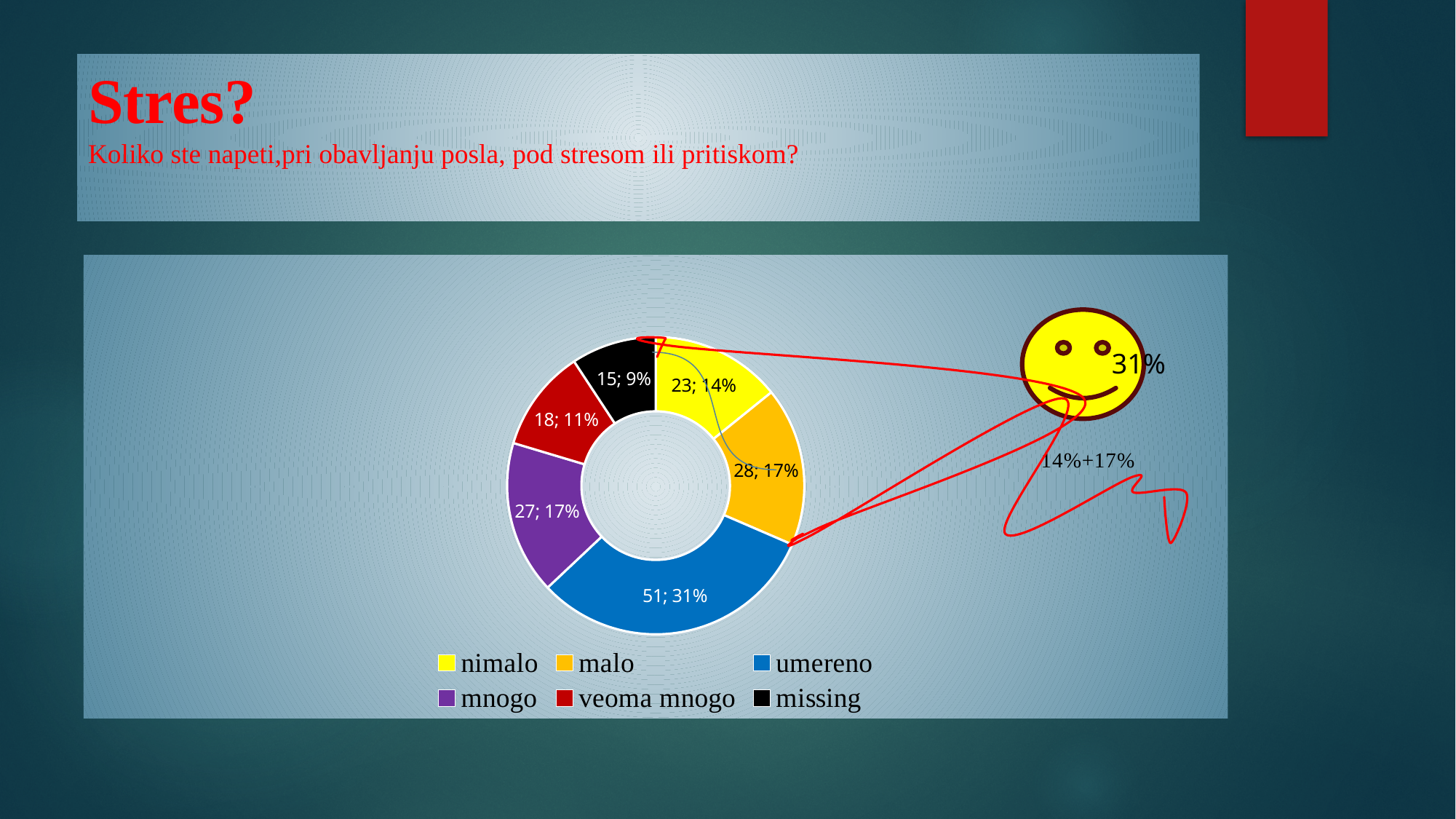
What is the difference in count between 'umereno' and 'malo'? 23 What count is shown for the 'veoma mnogo' slice? 18 What colour is the 'umereno' slice in the chart? blue Which has a larger count, 'mnogo' or 'veoma mnogo'? mnogo Which category has the smallest slice? missing How many categories does the doughnut chart have? 6 What percentage is shown for the 'missing' slice? 9% What share of the doughnut does the 'malo' slice represent? 17% What is the count and percentage shown for the 'umereno' slice? 51; 31% Which category has the largest slice? umereno What kind of chart is shown on the slide? doughnut chart What is the count and percentage shown for the 'nimalo' slice? 23; 14%